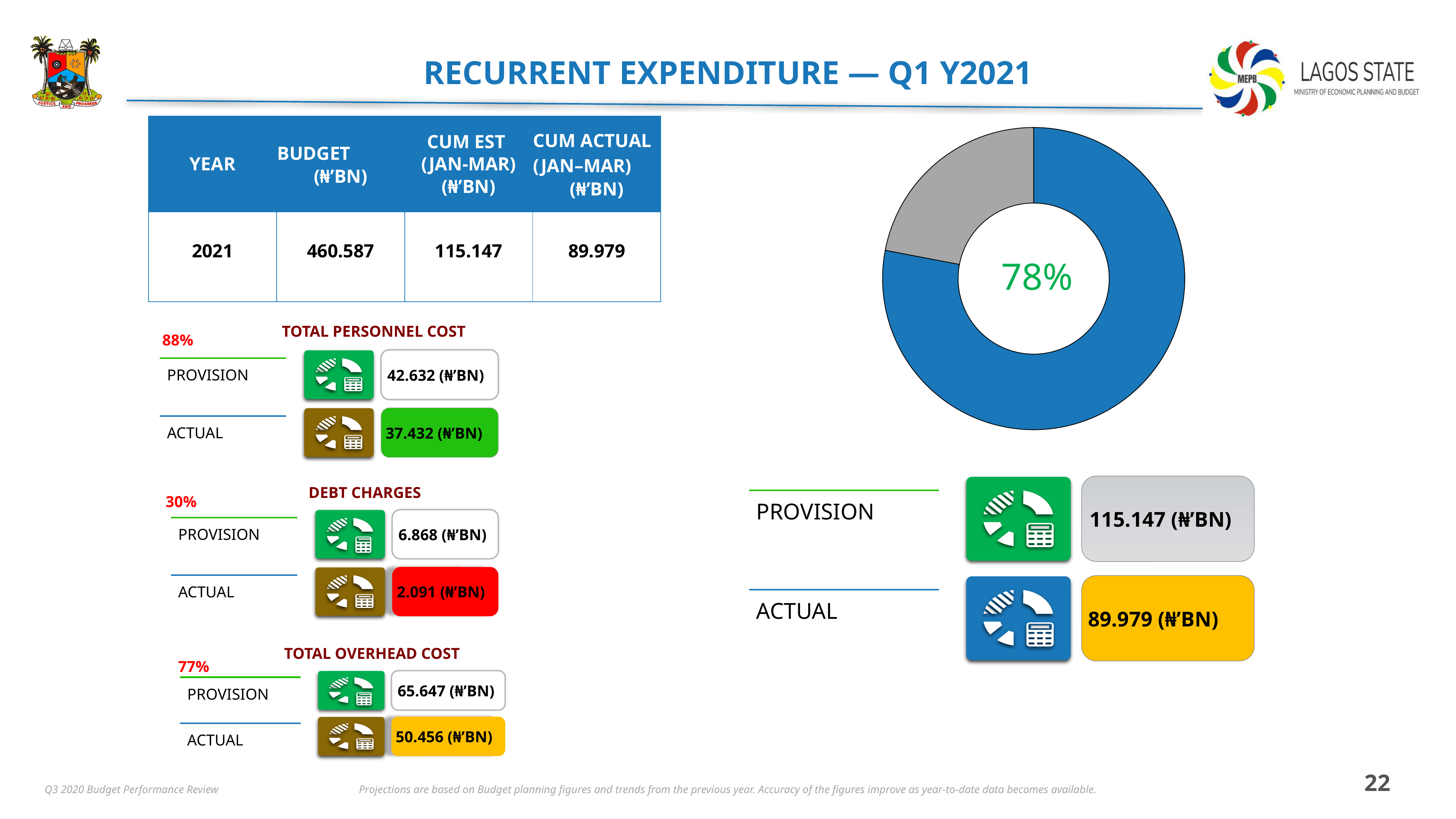
Which slice of the donut chart is larger, the blue one or the grey one? blue What kind of chart is shown on the right side of the slide? donut (pie) chart What share of the donut chart does the blue slice represent? 78% Beneath the donut chart, what is the difference between the PROVISION value (115.147) and the ACTUAL value (89.979)? 25.168 What is the PROVISION value shown beneath the donut chart? 115.147 (₦'BN) What colour is the smaller slice of the donut chart? grey What colour is the text showing the percentage in the centre of the donut chart? green How many slices does the donut chart have? 2 What is the ACTUAL value shown beneath the donut chart? 89.979 (₦'BN) What percentage is printed in the centre of the donut chart? 78% Beneath the donut chart, which is larger, the PROVISION value or the ACTUAL value? PROVISION Is the blue slice of the donut chart greater or less than 50% of the whole? greater